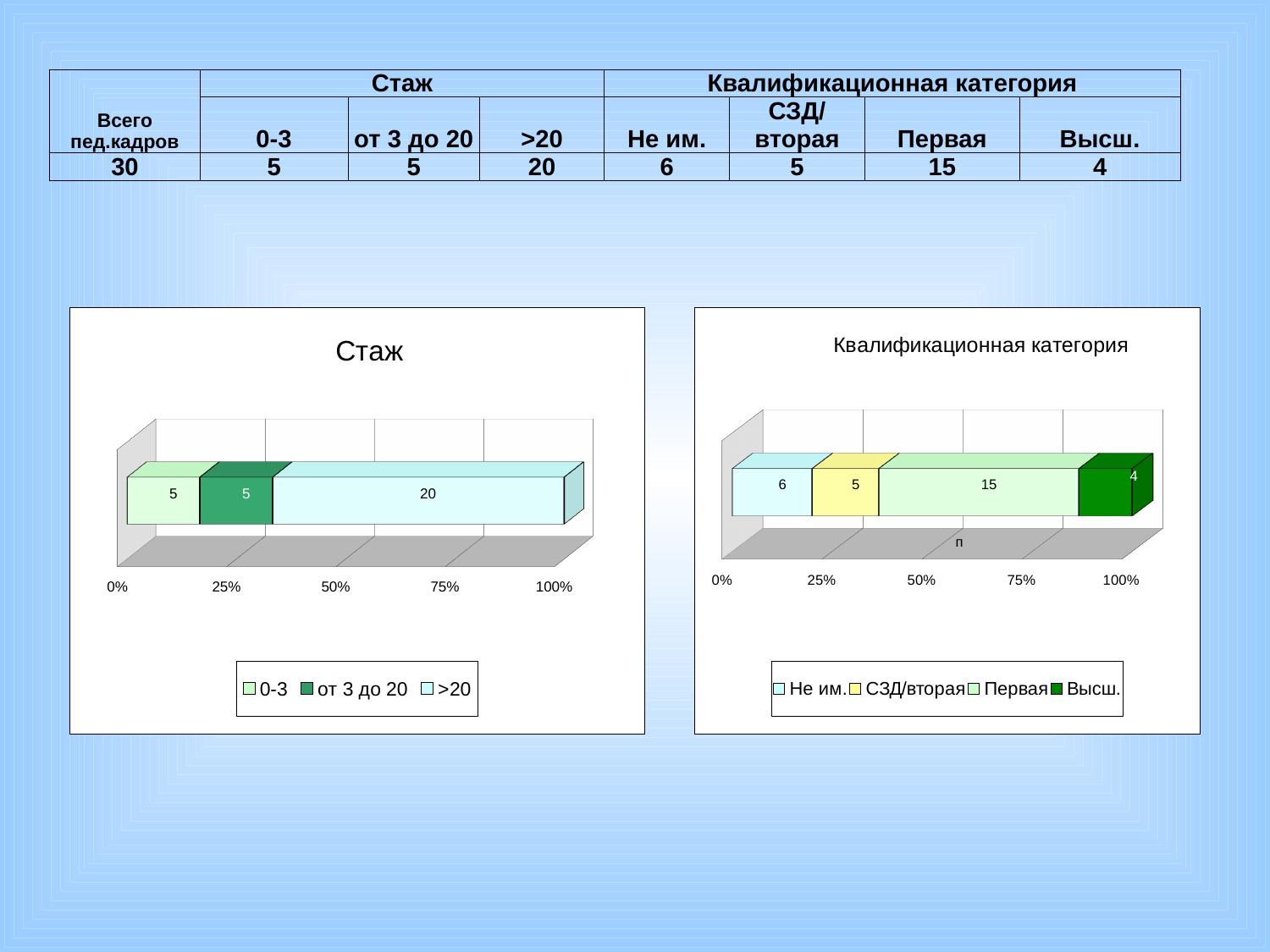
In the chart titled "Квалификационная категория", what is the value for "Первая"? 15 In the chart titled "Квалификационная категория", which is larger: the value for "Не им." or the value for "Высш."? Не им. In the chart titled "Квалификационная категория", what is the value for "Не им."? 6 In the chart titled "Квалификационная категория", which series has the lowest value? Высш. In the chart titled "Стаж", what is the total of the stacked bar? 30 In the chart titled "Стаж", what is the difference between the ">20" value and the "0-3" value? 15 What kind of chart is the chart titled "Стаж"? Stacked bar chart In the chart titled "Стаж", what is the value for the "0-3" series? 5 How many series does the legend of the chart titled "Квалификационная категория" list? 4 In the chart titled "Квалификационная категория", which series has the highest value? Первая In the chart titled "Стаж", what is the value for the ">20" series? 20 In the chart titled "Квалификационная категория", what is the total of the stacked bar? 30